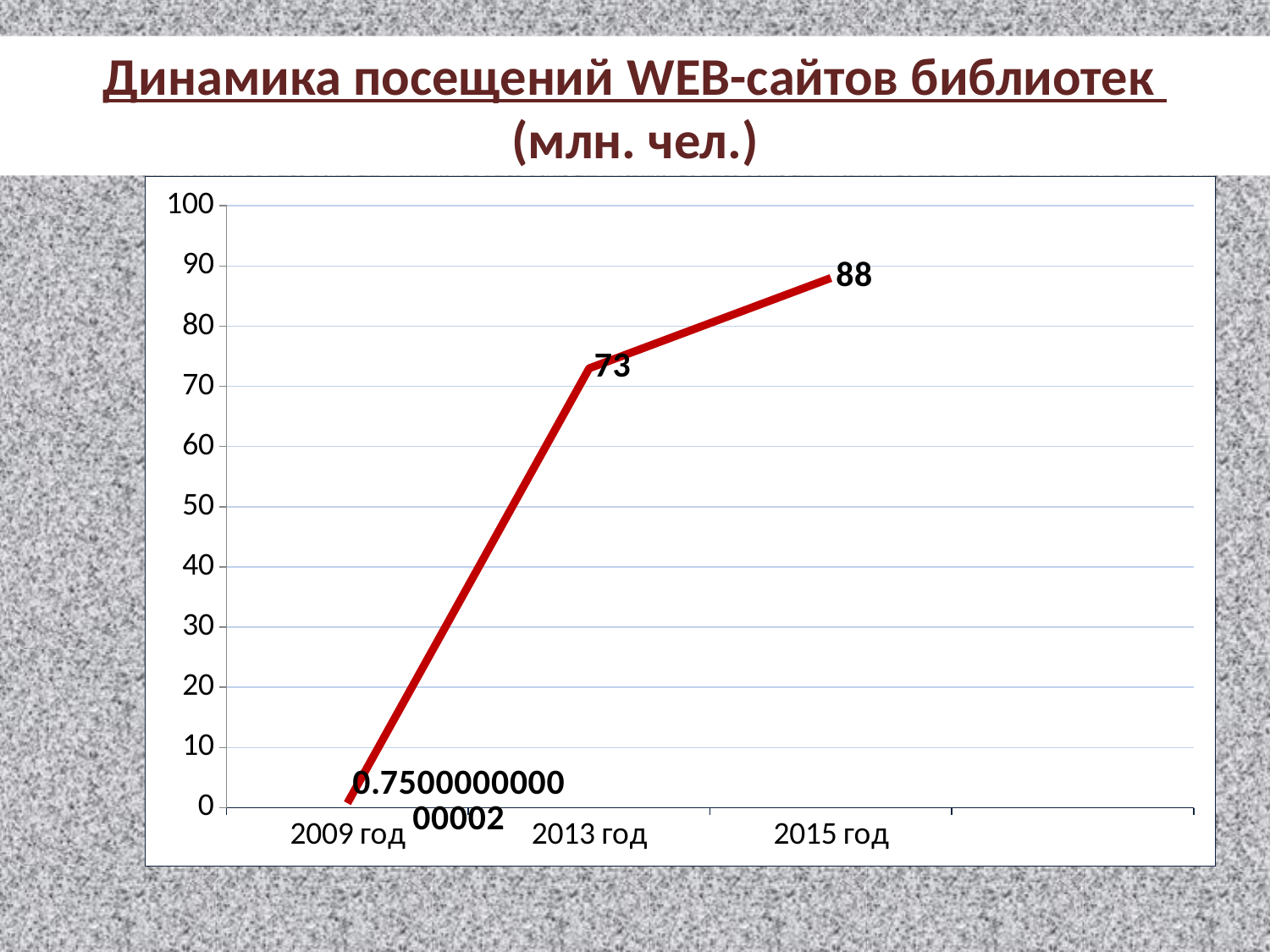
Which year has the lowest value? 2009 год What is the value for 2015 год? 88 What unit is given in the chart title? млн. чел. Which is larger, the value for 2013 год or the value for 2015 год? 2015 год What kind of chart is shown on the slide? line chart Do the values rise or fall from 2009 год to 2015 год? rise Which year has the highest value? 2015 год What is the value for 2013 год? 73 How many data points are plotted on the chart? 3 What is the difference between the values for 2015 год and 2013 год? 15 Is the value for 2009 год greater or less than 10? less What value is printed at the 2009 год point? 0.750000000000002